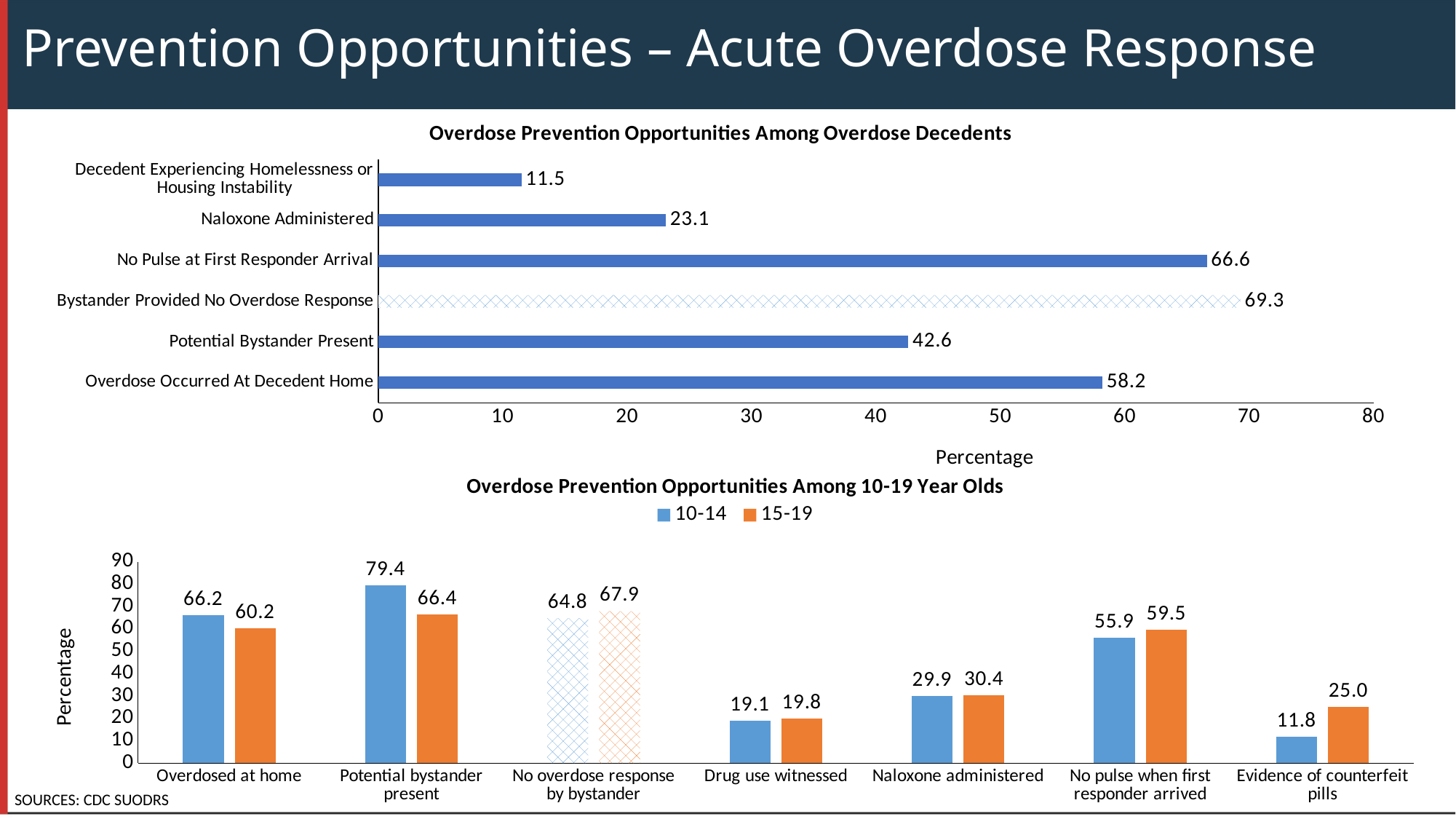
What kind of chart is 'Overdose Prevention Opportunities Among Overdose Decedents'? Bar chart In the 'Overdose Prevention Opportunities Among Overdose Decedents' chart, which category has the highest value? Bystander Provided No Overdose Response In the 'Overdose Prevention Opportunities Among 10-19 Year Olds' chart, which category has the lowest 10-14 value? Evidence of counterfeit pills In the 'Overdose Prevention Opportunities Among Overdose Decedents' chart, what is the value for Naloxone Administered? 23.1 In the 'Overdose Prevention Opportunities Among 10-19 Year Olds' chart, how many series does the legend list? 2 In the 'Overdose Prevention Opportunities Among 10-19 Year Olds' chart, what is the difference between 15-19 and 10-14 for Evidence of counterfeit pills? 13.2 In the 'Overdose Prevention Opportunities Among Overdose Decedents' chart, what is the difference between Overdose Occurred At Decedent Home and Potential Bystander Present? 15.6 In the 'Overdose Prevention Opportunities Among 10-19 Year Olds' chart, what is the value for 15-19 for Evidence of counterfeit pills? 25.0 In the 'Overdose Prevention Opportunities Among Overdose Decedents' chart, how many categories are shown? 6 In the 'Overdose Prevention Opportunities Among 10-19 Year Olds' chart, what is the value for 10-14 for Potential bystander present? 79.4 In the 'Overdose Prevention Opportunities Among Overdose Decedents' chart, which category has the lowest value? Decedent Experiencing Homelessness or Housing Instability In the 'Overdose Prevention Opportunities Among 10-19 Year Olds' chart, which is larger for Overdosed at home: 10-14 or 15-19? 10-14